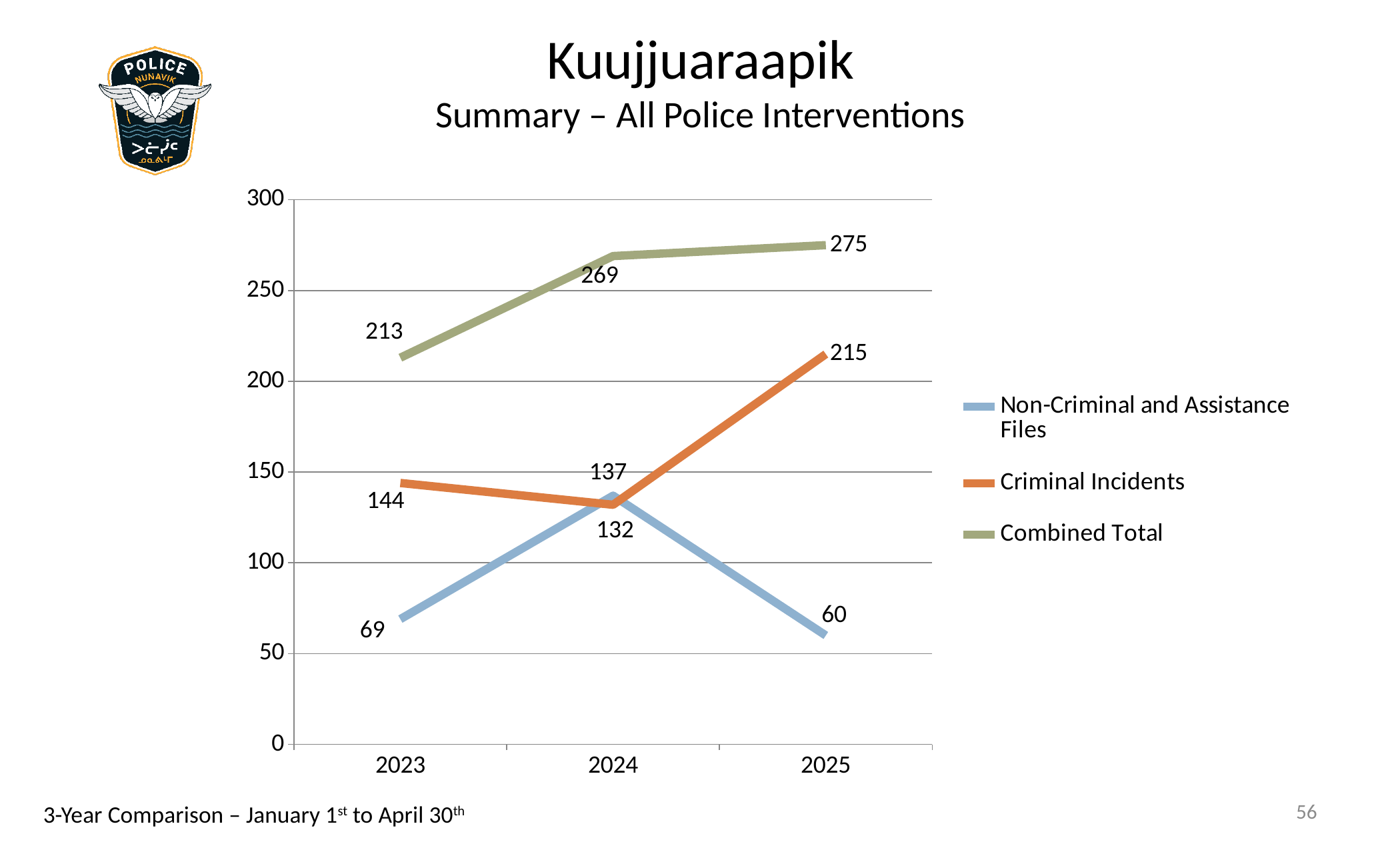
What is the difference between Criminal Incidents in 2025 and in 2024? 83 What kind of chart is shown on the slide? Line chart Is the value for Criminal Incidents in 2023 greater or less than 100? greater What is the value for Non-Criminal and Assistance Files in 2023? 69 What is the Combined Total for 2024? 269 Does the Combined Total rise or fall from 2023 to 2025? Rise What is the value for Criminal Incidents in 2025? 215 How many series does the legend list? 3 In which year is the Combined Total highest? 2025 In which year is the value for Non-Criminal and Assistance Files lowest? 2025 How many years are shown on the x axis? 3 Which is larger in 2024: Non-Criminal and Assistance Files or Criminal Incidents? Non-Criminal and Assistance Files